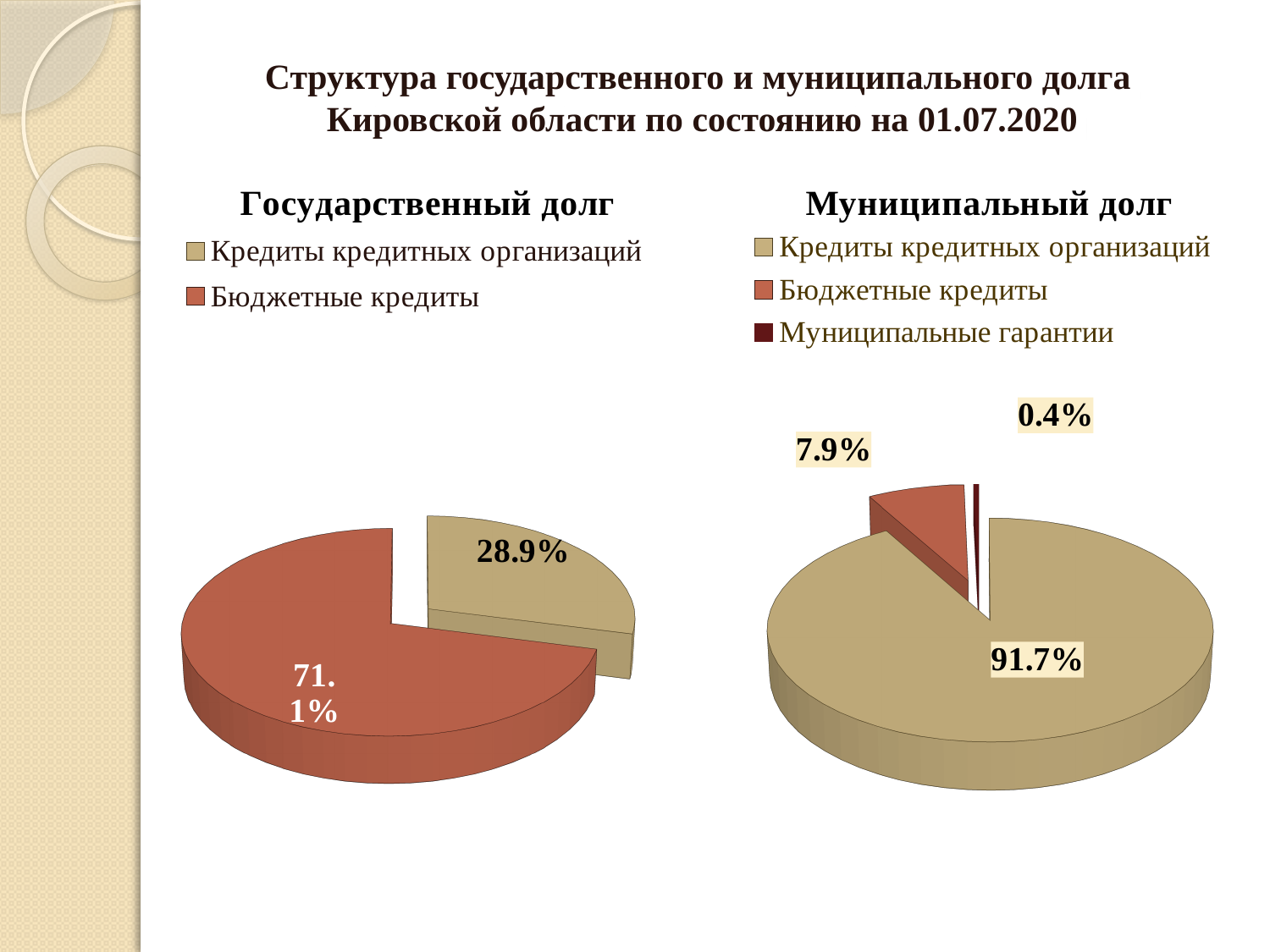
In the 'Государственный долг' chart, what is the difference in percentage points between 'Бюджетные кредиты' and 'Кредиты кредитных организаций'? 42.2 In the 'Муниципальный долг' chart, which category has the smallest slice? Муниципальные гарантии In the 'Муниципальный долг' chart, what share is labelled for 'Кредиты кредитных организаций'? 91.7% In the 'Муниципальный долг' chart, which category has the largest slice? Кредиты кредитных организаций In the 'Государственный долг' chart, which category has the largest slice? Бюджетные кредиты How many slices does the 'Государственный долг' chart have? 2 How many categories does the legend of the 'Муниципальный долг' chart list? 3 In the 'Муниципальный долг' chart, what share is labelled for 'Бюджетные кредиты'? 7.9% In the 'Государственный долг' chart, what share is labelled for 'Бюджетные кредиты'? 71.1% What type of chart is used for 'Муниципальный долг'? Pie chart In the 'Государственный долг' chart, what share is labelled for 'Кредиты кредитных организаций'? 28.9% In the 'Муниципальный долг' chart, what share is labelled for 'Муниципальные гарантии'? 0.4%